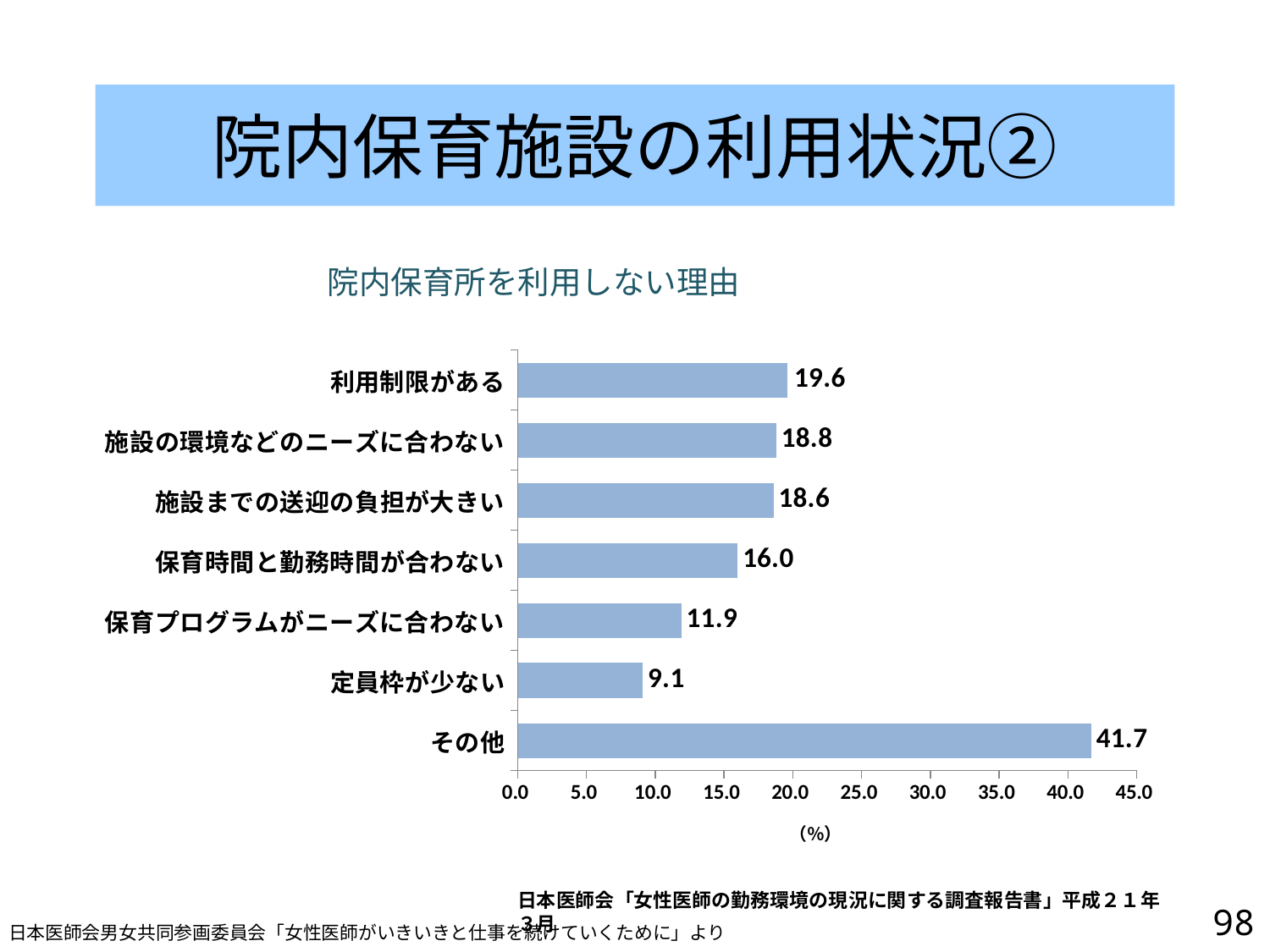
Which category has the lowest value? 定員枠が少ない What is the value for 利用制限がある? 19.6 What is the difference between the values for その他 and 利用制限がある? 22.1 What is the title of the chart? 院内保育所を利用しない理由 How many categories are shown in the chart? 7 Is the value for その他 greater or less than 40.0? greater Which category has the highest value? その他 What is the difference between the values for 保育プログラムがニーズに合わない and 定員枠が少ない? 2.8 Which is larger, the value for 施設の環境などのニーズに合わない or the value for 保育時間と勤務時間が合わない? 施設の環境などのニーズに合わない What is the value for 定員枠が少ない? 9.1 What kind of chart is shown on the slide? bar chart What is the value for 保育時間と勤務時間が合わない? 16.0